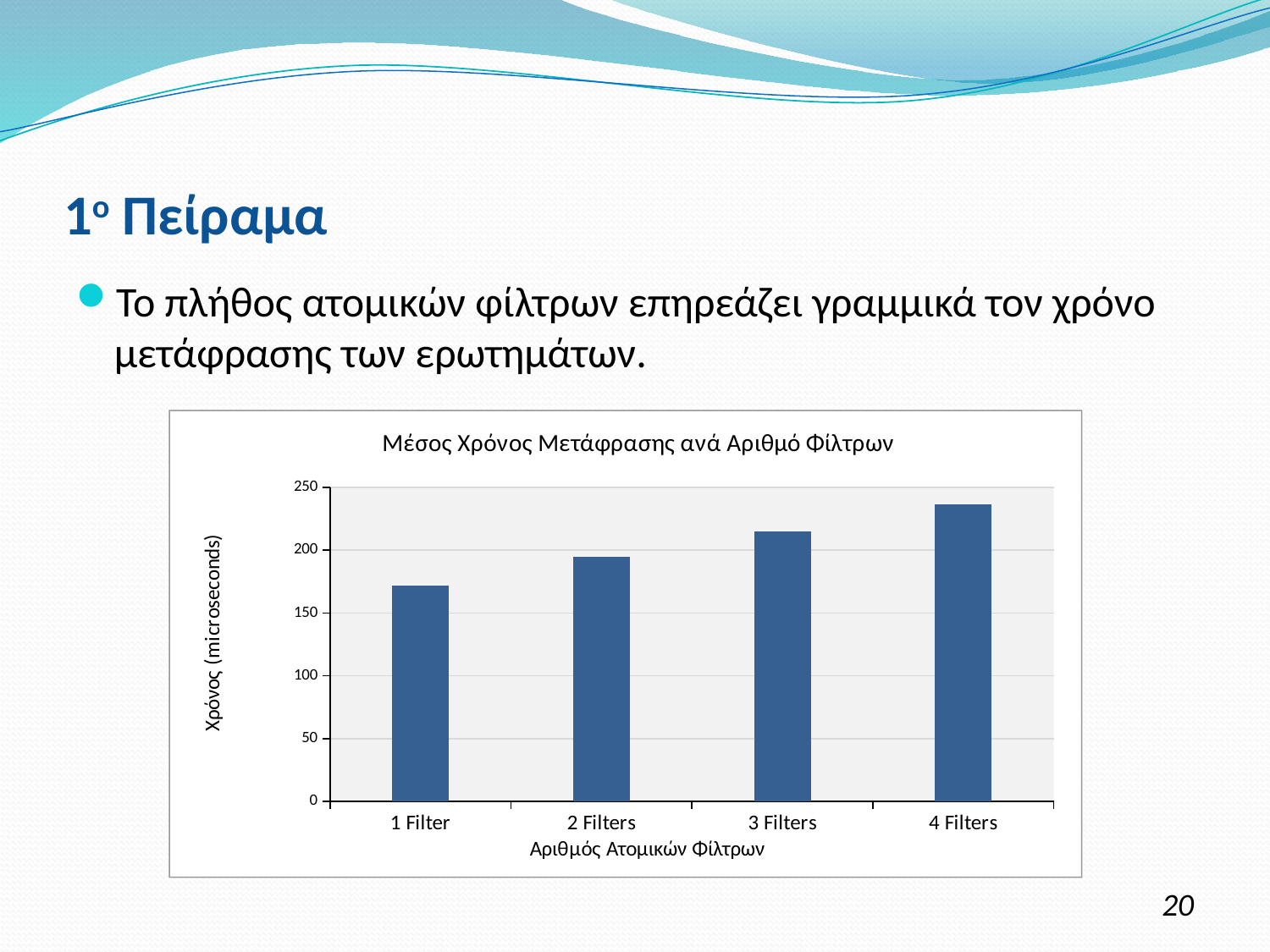
What is the title of the chart? Μέσος Χρόνος Μετάφρασης ανά Αριθμό Φίλτρων Is the value for 3 Filters greater or less than 200? greater What is the label of the y axis of the chart? Χρόνος (microseconds) How many categories are plotted on the x axis of the chart? 4 Which is larger, the value for 3 Filters or the value for 1 Filter? 3 Filters What kind of chart is shown on the slide? bar chart Is the value for 1 Filter greater or less than 150? greater Is the value for 4 Filters greater or less than 250? less Do the values rise or fall as the number of filters increases along the x axis? rise Which category has the highest value in the chart? 4 Filters Which category has the lowest value in the chart? 1 Filter